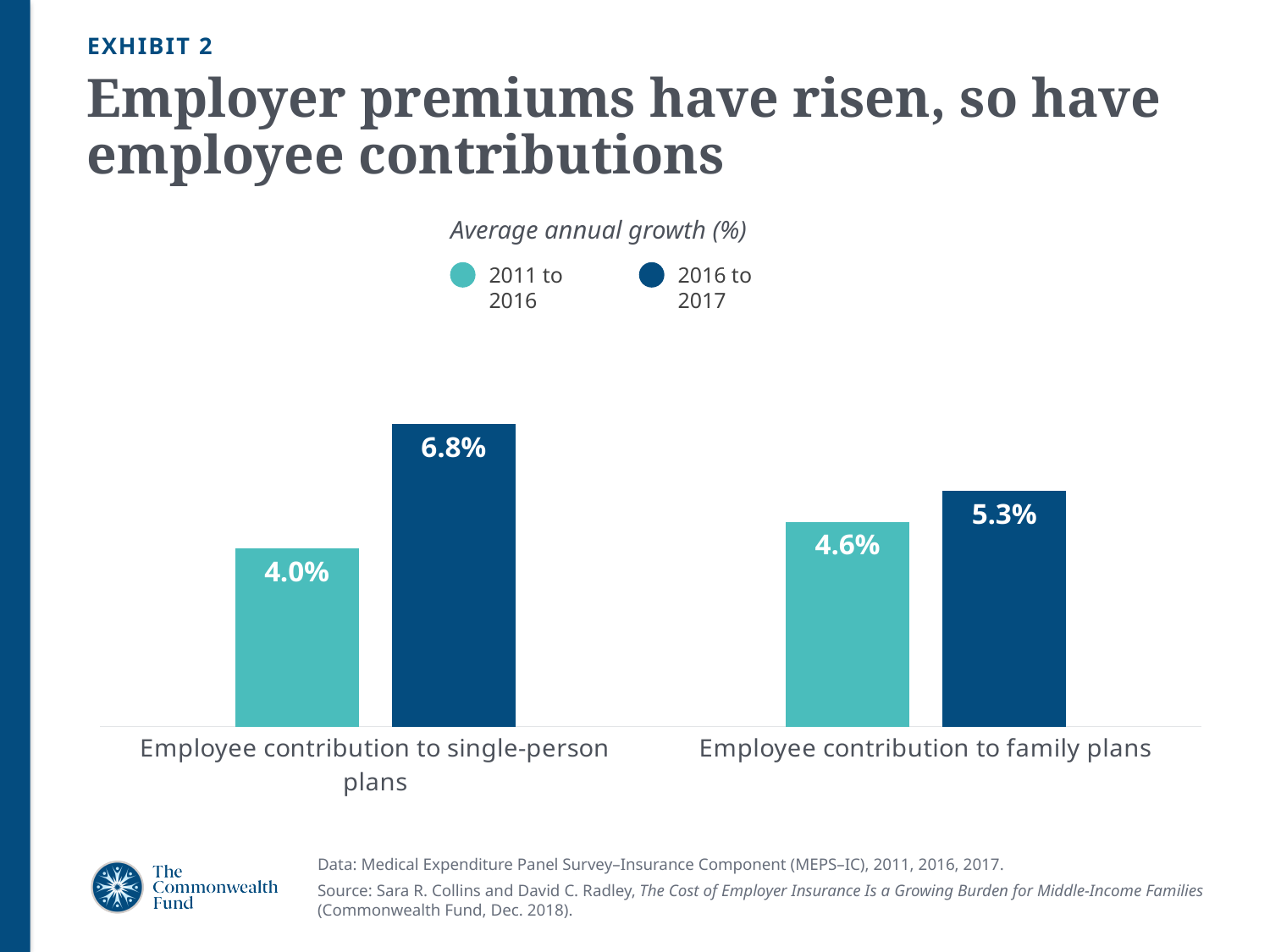
How many series does the legend list? 2 How many categories are shown on the x axis? 2 What is the average annual growth for employee contribution to single-person plans from 2011 to 2016? 4.0% Which category has the lowest value in the 2011 to 2016 series? Employee contribution to single-person plans What is the average annual growth for employee contribution to family plans from 2011 to 2016? 4.6% What is the average annual growth for employee contribution to family plans from 2016 to 2017? 5.3% What is the average annual growth for employee contribution to single-person plans from 2016 to 2017? 6.8% Which is larger: the 2011 to 2016 value for single-person plans or the 2011 to 2016 value for family plans? Family plans What is the difference between the 2016 to 2017 and 2011 to 2016 values for employee contribution to single-person plans? 2.8% What is the difference between the 2016 to 2017 and 2011 to 2016 values for employee contribution to family plans? 0.7% Which category has the highest value in the 2016 to 2017 series? Employee contribution to single-person plans What kind of chart is shown on the slide? Bar chart